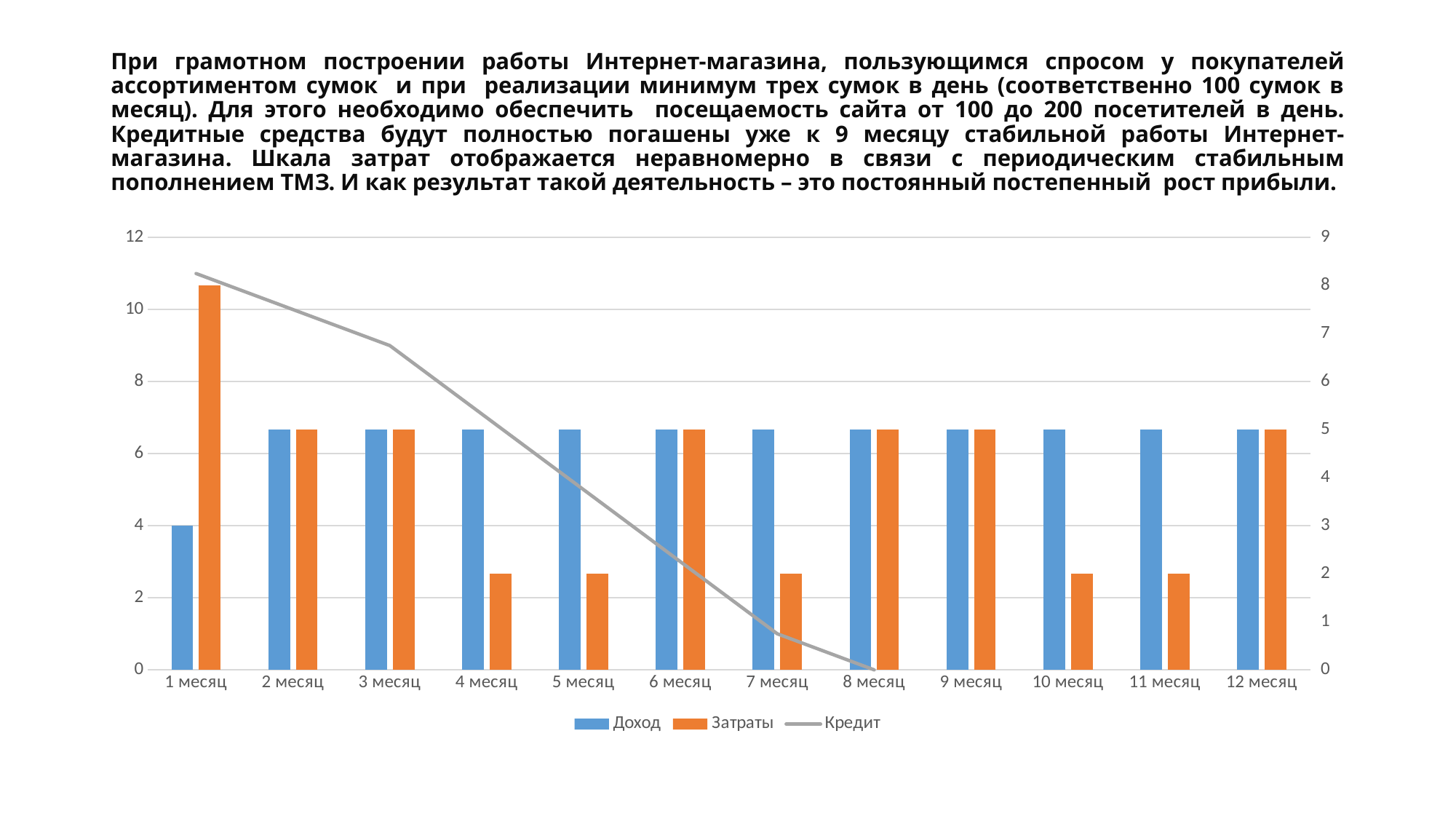
What kind of chart is shown on the slide? bar and line chart How many series does the legend list? 3 In which month is Доход lowest? 1 месяц Does the Кредит line rise or fall from 1 месяц to 8 месяц? fall For 1 месяц, which is larger: Доход or Затраты? Затраты Is the value of Затраты for 4 месяц greater or less than 4? less What colour are the Доход bars? blue In which month is Затраты highest? 1 месяц Is the Кредит value for 1 месяц on the right axis greater or less than 7? greater How many months are shown on the x axis? 12